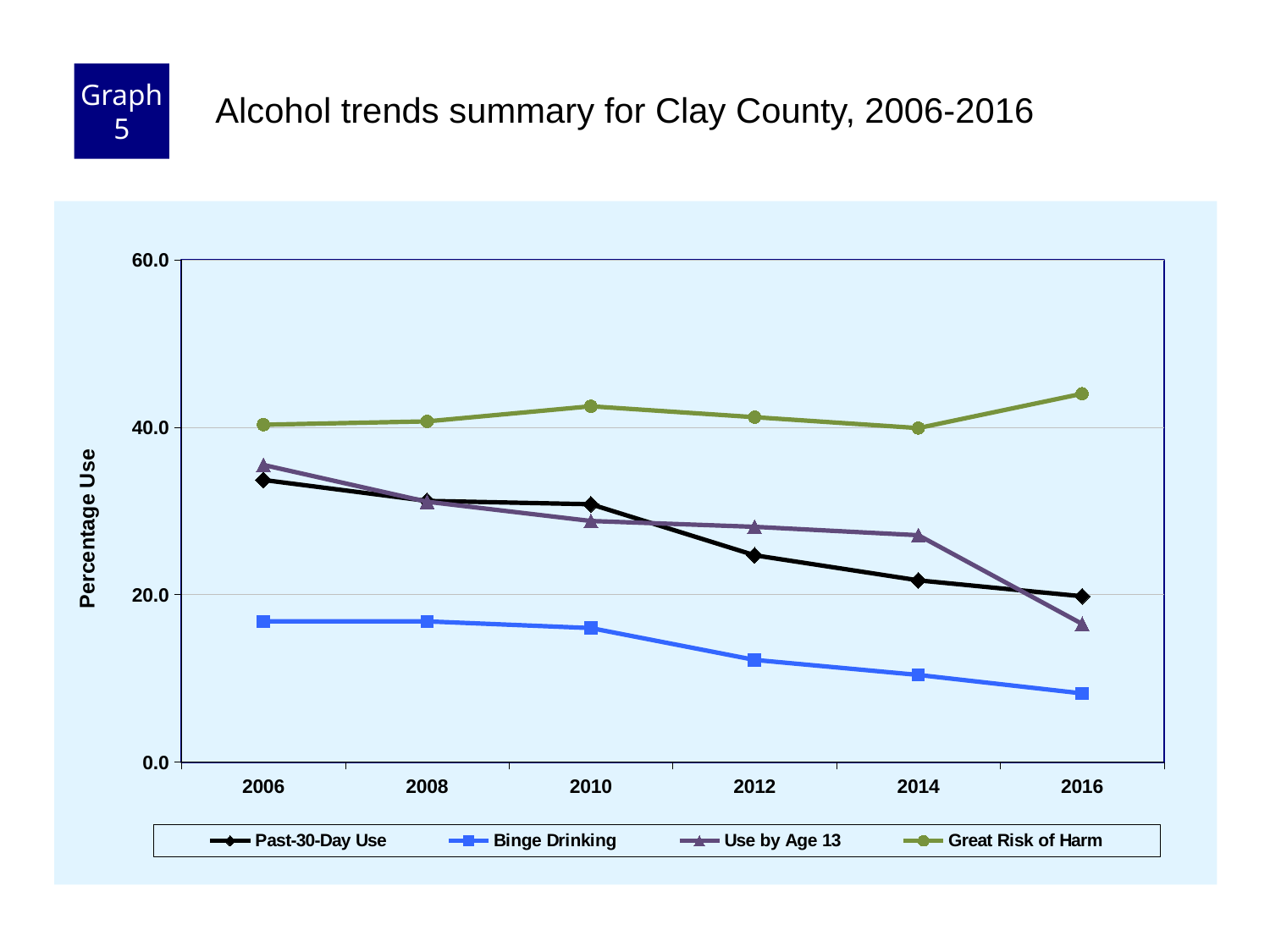
Does Binge Drinking rise or fall from 2006 to 2016? Fall Is the value for Binge Drinking in 2016 greater or less than 20.0? less Is the value for Great Risk of Harm in 2016 greater or less than 40.0? greater Which series has the highest value in 2016? Great Risk of Harm How many years are plotted along the x axis? 6 In 2016, which is higher: Past-30-Day Use or Use by Age 13? Past-30-Day Use How many series does the legend list? 4 What is the label on the y axis? Percentage Use What kind of chart is shown on the slide? Line chart In which year is Binge Drinking at its lowest? 2016 Is the value for Past-30-Day Use in 2006 greater or less than 40.0? less Which series has the lowest value in 2006? Binge Drinking